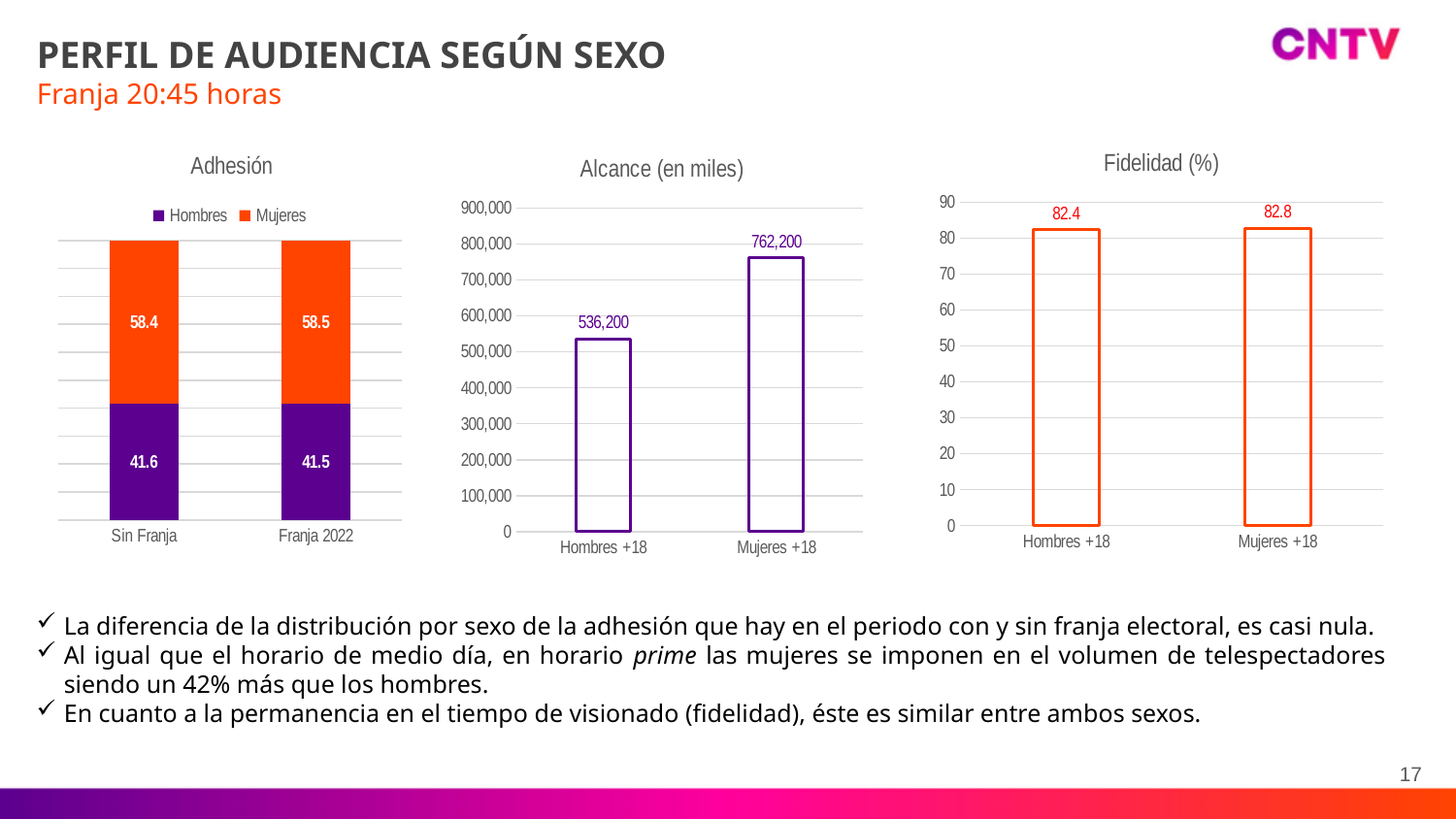
In the 'Adhesión' chart, what is the total of the Sin Franja stacked bar? 100 In the 'Fidelidad (%)' chart, what is the difference between the Mujeres +18 and Hombres +18 values? 0.4 In the 'Alcance (en miles)' chart, what is the value for Mujeres +18? 762,200 In the 'Adhesión' chart, which series has the larger value in the Franja 2022 bar, Hombres or Mujeres? Mujeres What kind of chart is the 'Fidelidad (%)' chart? Bar chart In the 'Fidelidad (%)' chart, what is the value for Hombres +18? 82.4 In the 'Adhesión' chart, what is the value for Hombres in the Sin Franja bar? 41.6 In the 'Alcance (en miles)' chart, which category has the highest value? Mujeres +18 In the 'Alcance (en miles)' chart, what is the value for Hombres +18? 536,200 In the 'Adhesión' chart, how many series does the legend list? 2 In the 'Alcance (en miles)' chart, what is the difference between the Mujeres +18 and Hombres +18 values? 226,000 In the 'Adhesión' chart, what is the value for Mujeres in the Franja 2022 bar? 58.5